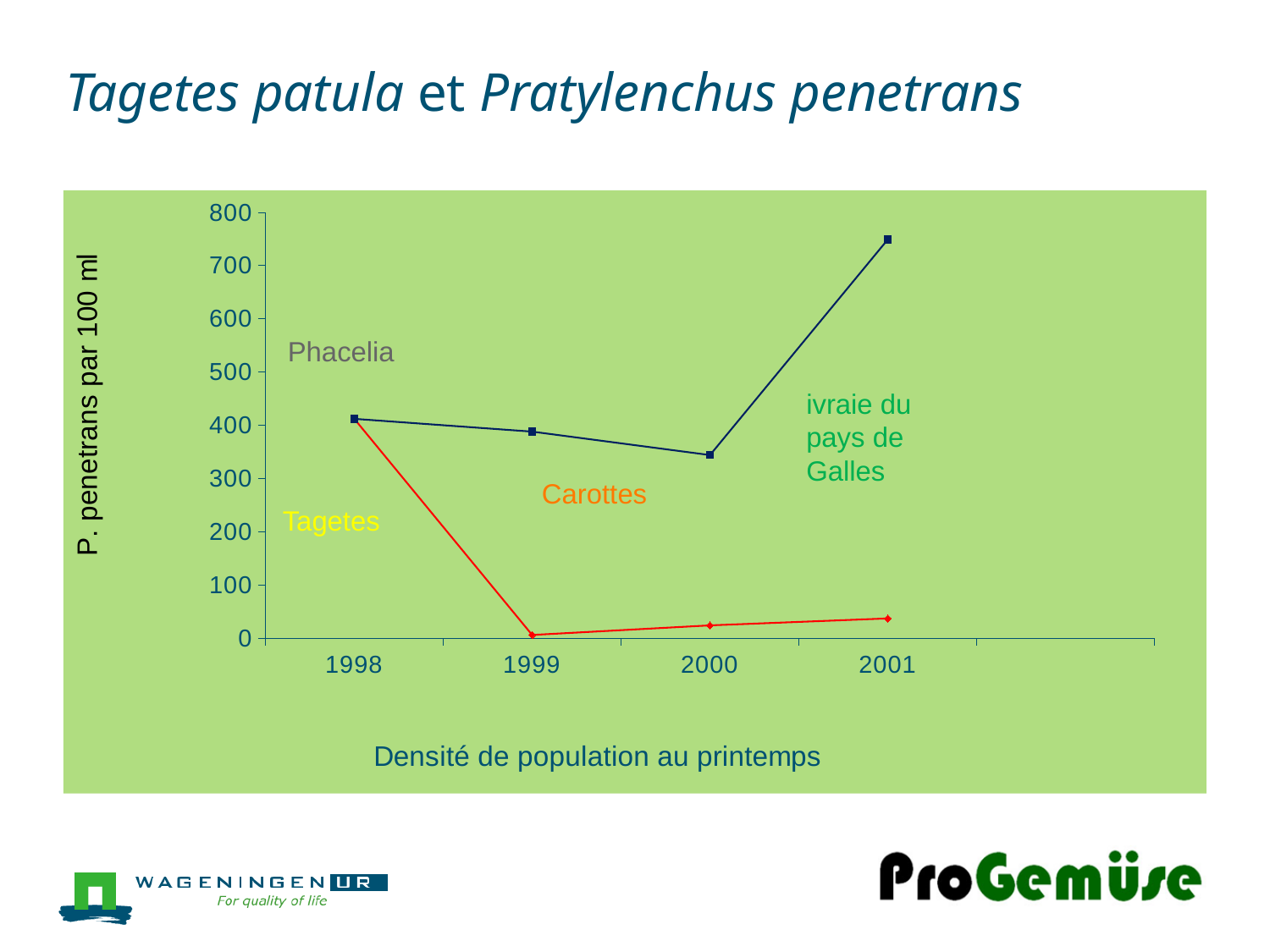
Is the value of the dark blue line in 2000 greater or less than 300? greater How many years are shown on the x axis of the chart? 4 In which year is the red line at its lowest value? 1999 What kind of chart is shown on the slide? line chart Is the value of the red line in 2001 greater or less than 100? less Does the dark blue line rise or fall between 2000 and 2001? rise In 2001, which line is higher, the dark blue line or the red line? the dark blue line Does the red line rise or fall between 1998 and 1999? fall In which year does the dark blue line reach its highest value? 2001 What is the title of the y axis of the chart? P. penetrans par 100 ml Is the value of the red line in 1999 greater or less than 100? less